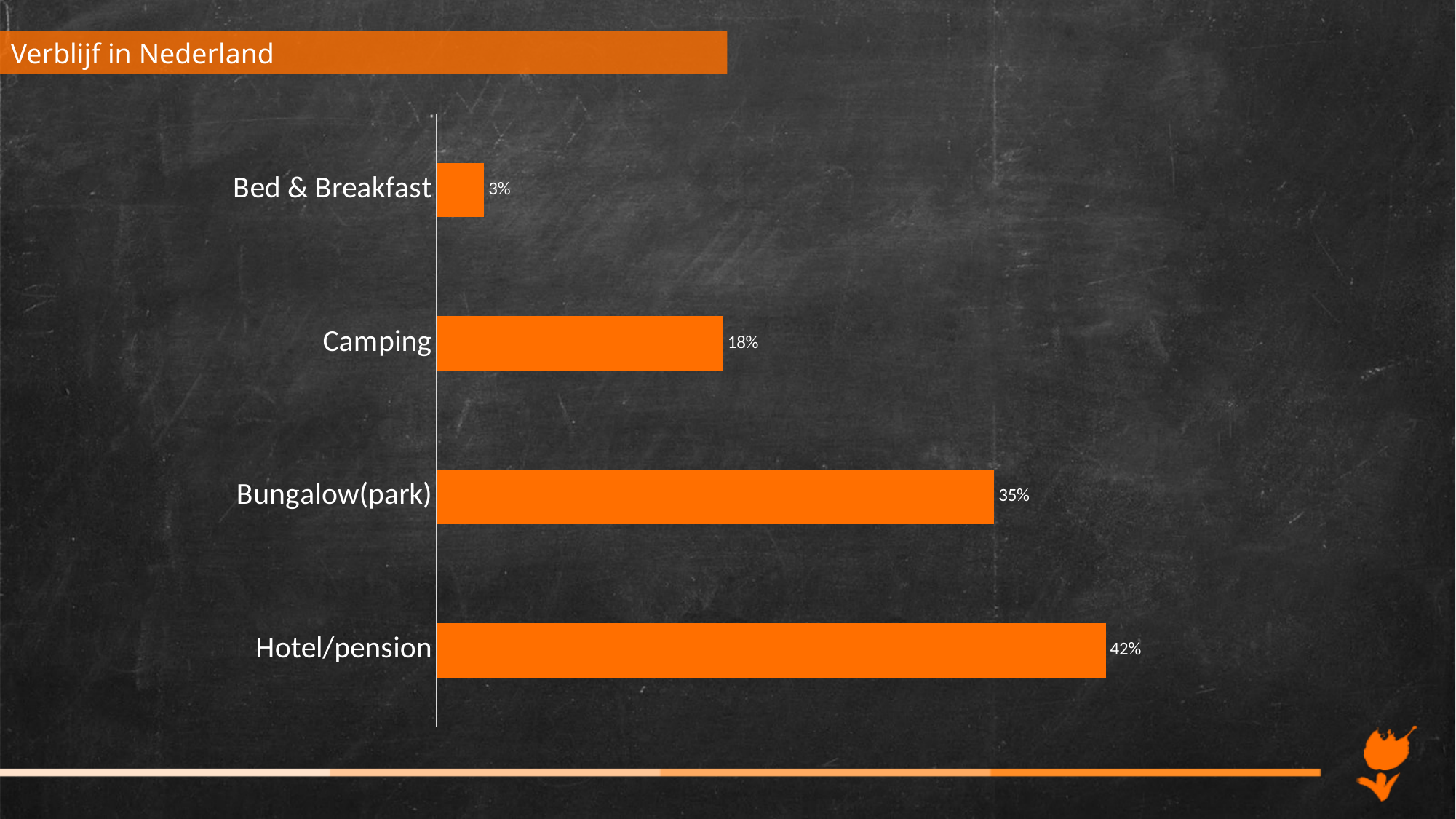
Which category has the highest value? Hotel/pension What is the difference between the values for Hotel/pension and Bungalow(park)? 7% What is the value for Hotel/pension? 42% What is the value for Camping? 18% How many categories are shown in the chart? 4 What is the value for Bed & Breakfast? 3% What is the title shown above the chart? Verblijf in Nederland Which category has the lowest value? Bed & Breakfast What kind of chart is shown on the slide? Bar chart What is the difference between the values for Camping and Bed & Breakfast? 15% What is the value for Bungalow(park)? 35% Which is larger, the value for Camping or the value for Bungalow(park)? Bungalow(park)